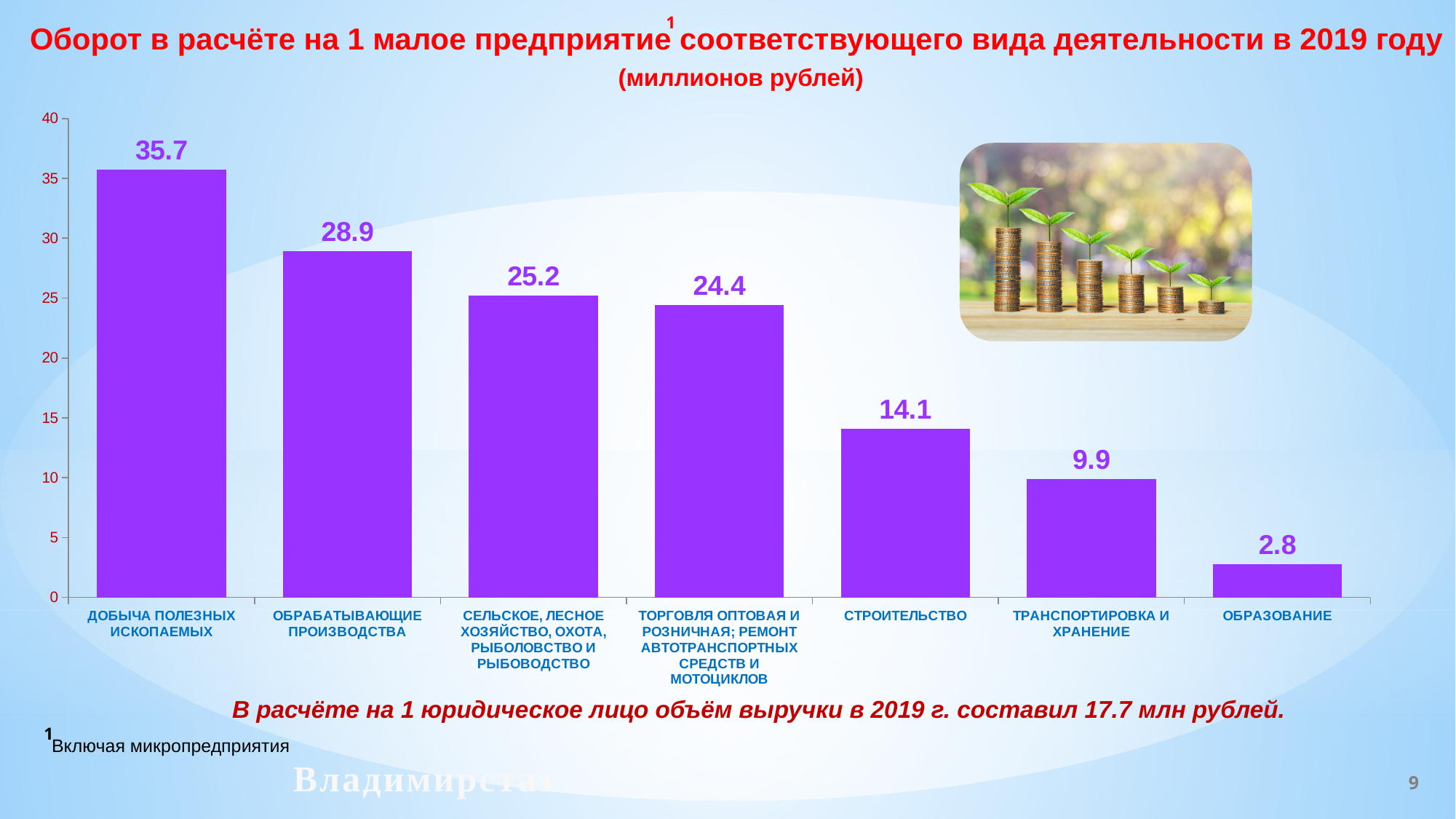
What is the difference between the values for Добыча полезных ископаемых and Транспортировка и хранение? 25.8 What is the value for Образование? 2.8 What is the turnover per small enterprise for Строительство? 14.1 In what units are the values in the chart expressed, according to the subtitle? миллионов рублей Which activity type has the highest turnover per small enterprise? Добыча полезных ископаемых Which activity type has the lowest turnover per small enterprise? Образование What value is shown for Обрабатывающие производства? 28.9 Is the value for Транспортировка и хранение greater or less than 10? less How many activity types are shown in the chart? 7 What kind of chart is shown on the slide? bar chart Which is larger: the value for Сельское, лесное хозяйство, охота, рыболовство и рыбоводство or the value for Торговля оптовая и розничная; ремонт автотранспортных средств и мотоциклов? Сельское, лесное хозяйство, охота, рыболовство и рыбоводство Do the values rise or fall from left to right across the categories? fall